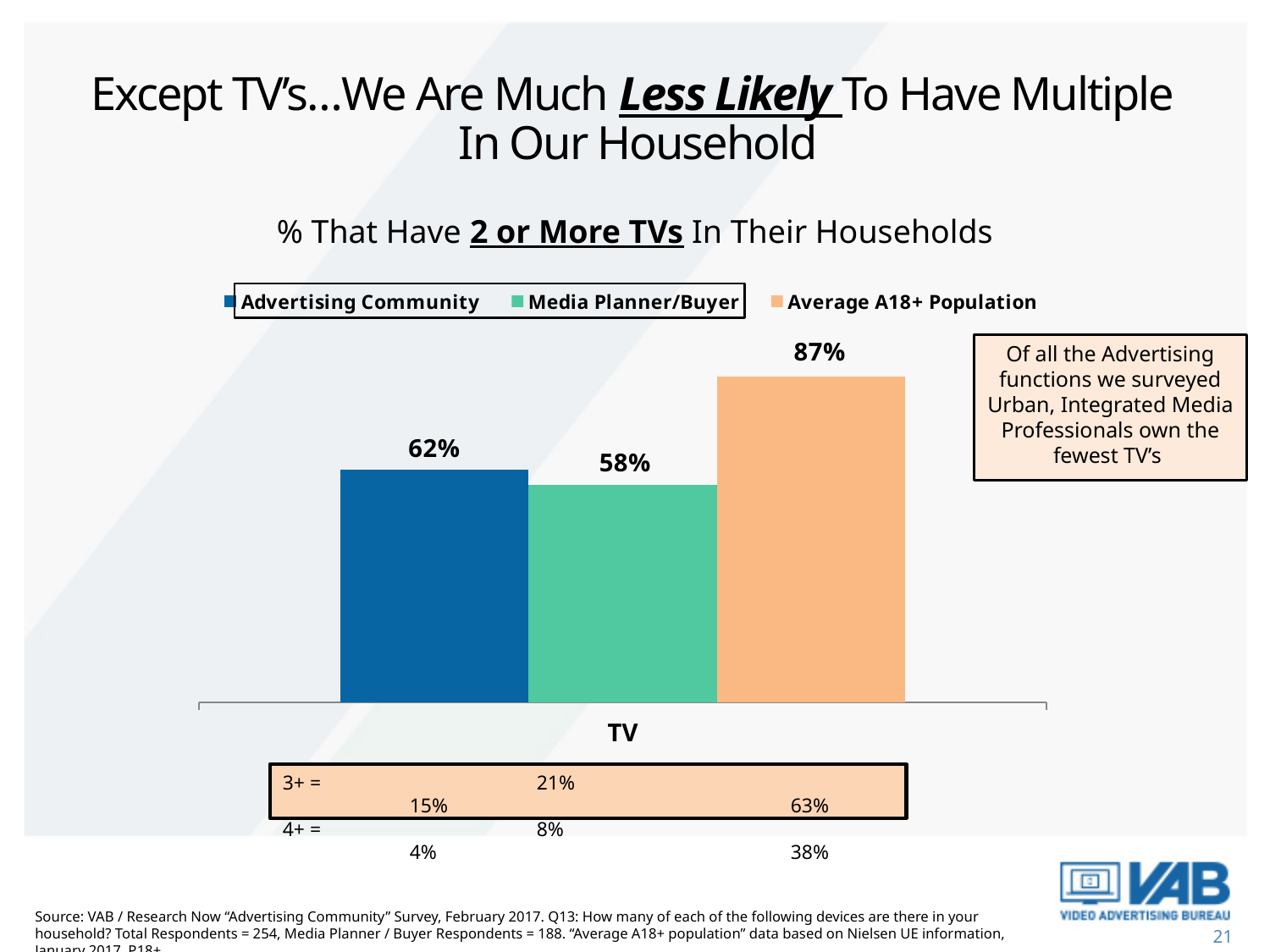
What is the difference between the Advertising Community and Media Planner/Buyer percentages for 2 or more TVs? 4% What is the difference between the Average A18+ Population and the Advertising Community percentages for 2 or more TVs? 25% What percentage of the Average A18+ Population has 2 or more TVs in their household? 87% Which series has the highest percentage of households with 2 or more TVs? Average A18+ Population How many series does the chart legend list? 3 What percentage of Media Planner/Buyer respondents have 2 or more TVs in their household? 58% What type of chart is shown on the slide? Bar chart What colour is the bar for the Average A18+ Population series? Orange Which series has the lowest percentage of households with 2 or more TVs? Media Planner/Buyer What is the category label shown on the x axis of the chart? TV What percentage of the Advertising Community has 2 or more TVs in their household? 62% Which is larger: the Advertising Community value or the Media Planner/Buyer value for 2 or more TVs? Advertising Community